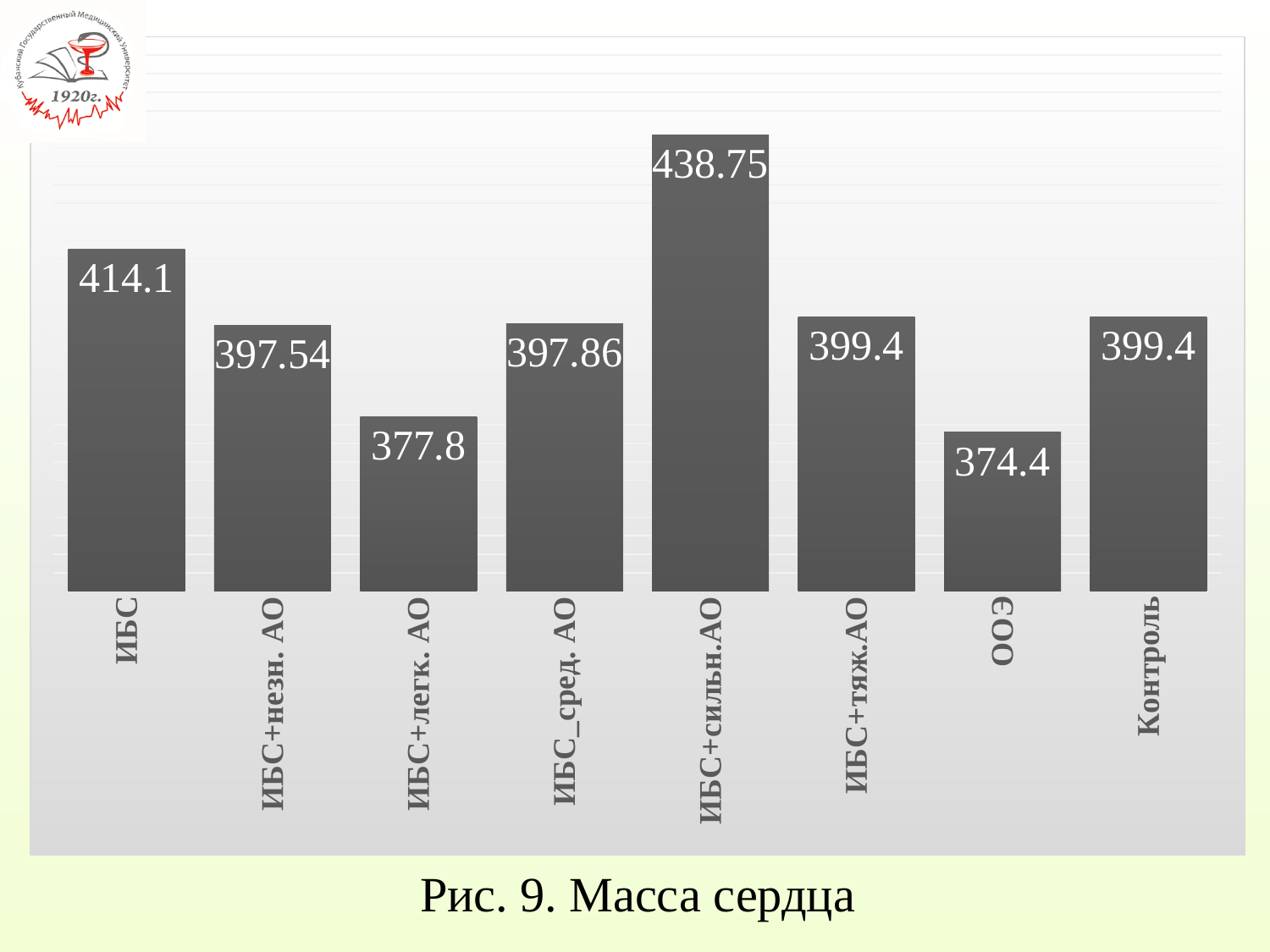
What is the difference between the values for ИБС+сильн.АО and ИБС? 24.65 What is the value for ИБС+сильн.АО? 438.75 What is the value for ИБС? 414.1 What is the value for Контроль? 399.4 Which category has the highest value? ИБС+сильн.АО What type of chart is shown on the slide? bar chart Which is larger, the value for ИБС or the value for ИБС+тяж.АО? ИБС How many categories are shown in the chart? 8 What is the value for ИБС+легк. АО? 377.8 Which category has the lowest value? ООЭ